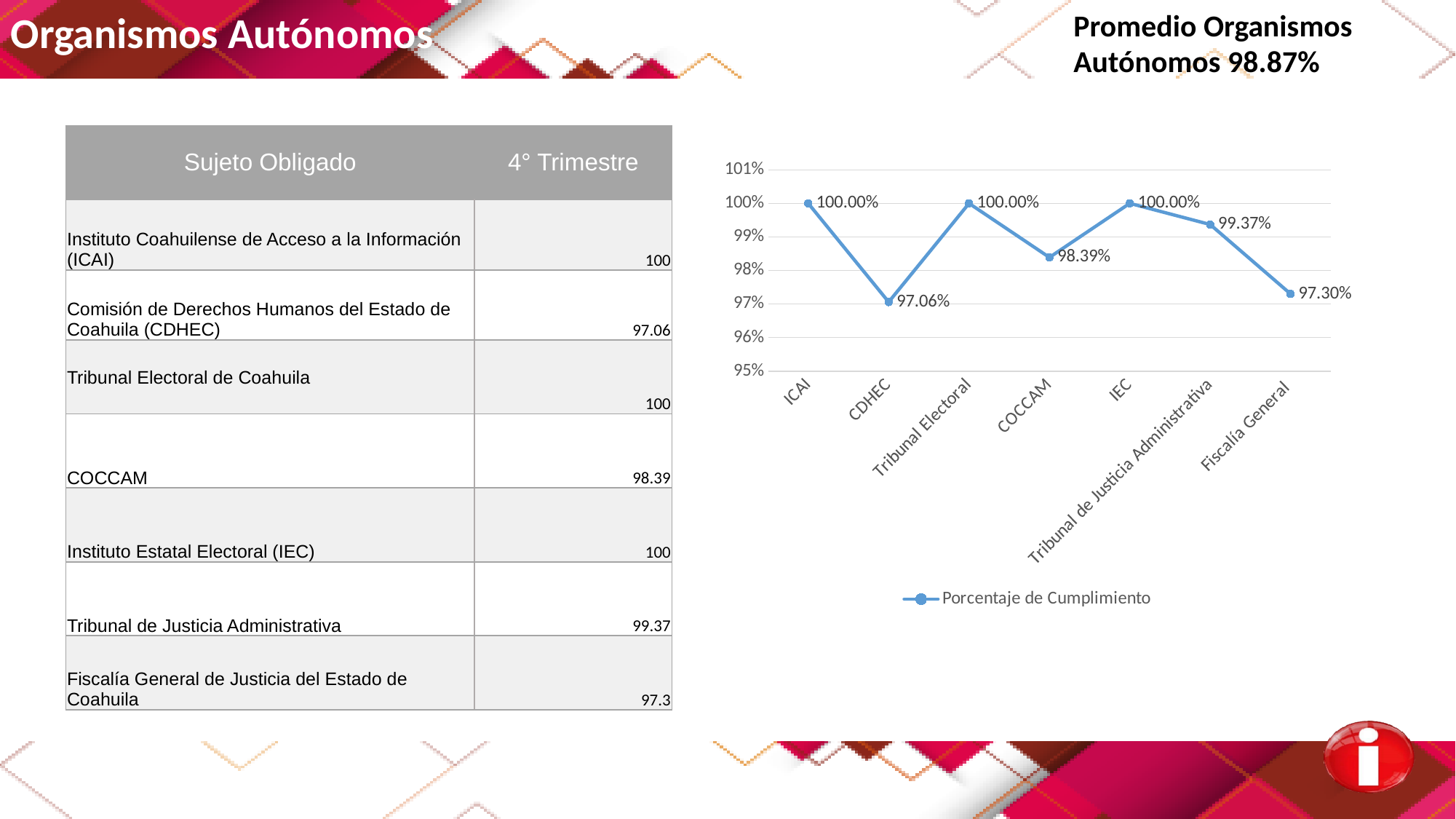
Which category has the lowest value in the chart? CDHEC What is the value for Tribunal de Justicia Administrativa in the chart? 99.37% What is the difference between the values for COCCAM and CDHEC? 1.33% What kind of chart is shown on the slide? line chart What is the difference between the values for IEC and Fiscalía General? 2.70% Is the value for Fiscalía General greater or less than 98%? less What series name does the chart legend show? Porcentaje de Cumplimiento What is the value for COCCAM in the chart? 98.39% What is the value for Fiscalía General in the chart? 97.30% What is the value for CDHEC in the chart? 97.06% Which is larger, the value for COCCAM or the value for Tribunal de Justicia Administrativa? Tribunal de Justicia Administrativa How many categories are plotted on the x axis of the chart? 7